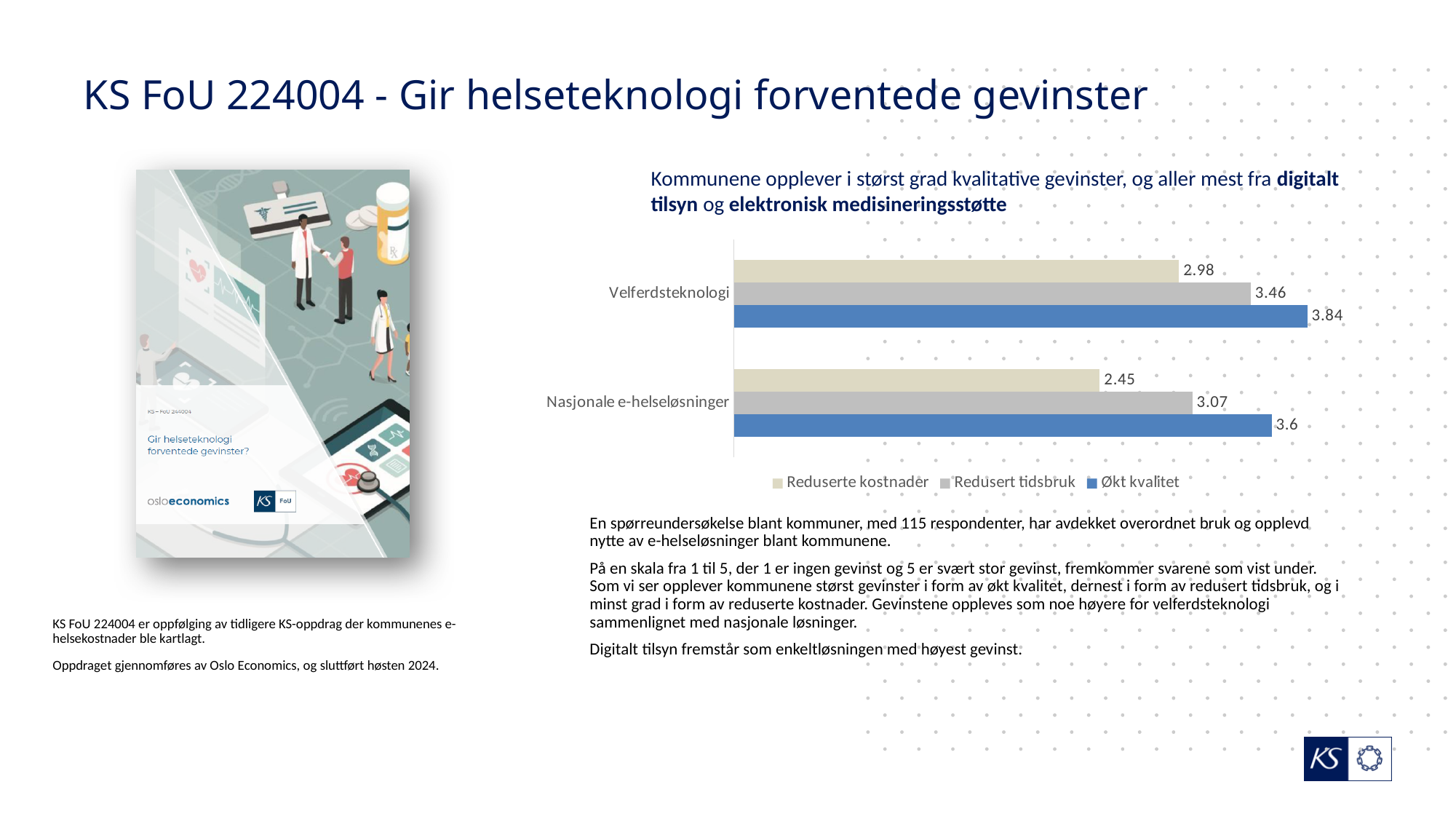
What is the value for Økt kvalitet for Nasjonale e-helseløsninger? 3.6 What is the difference between Økt kvalitet and Reduserte kostnader for Velferdsteknologi? 0.86 How many series does the legend list? 3 What is the value for Økt kvalitet for Velferdsteknologi? 3.84 Which series has the highest value for Velferdsteknologi? Økt kvalitet What is the difference between Redusert tidsbruk for Velferdsteknologi and Redusert tidsbruk for Nasjonale e-helseløsninger? 0.39 What is the value for Reduserte kostnader for Nasjonale e-helseløsninger? 2.45 Which series has the lowest value for Nasjonale e-helseløsninger? Reduserte kostnader What kind of chart is shown on the slide? Bar chart What is the value for Redusert tidsbruk for Velferdsteknologi? 3.46 Which is larger: Reduserte kostnader for Velferdsteknologi or Reduserte kostnader for Nasjonale e-helseløsninger? Velferdsteknologi How many categories are shown on the chart? 2